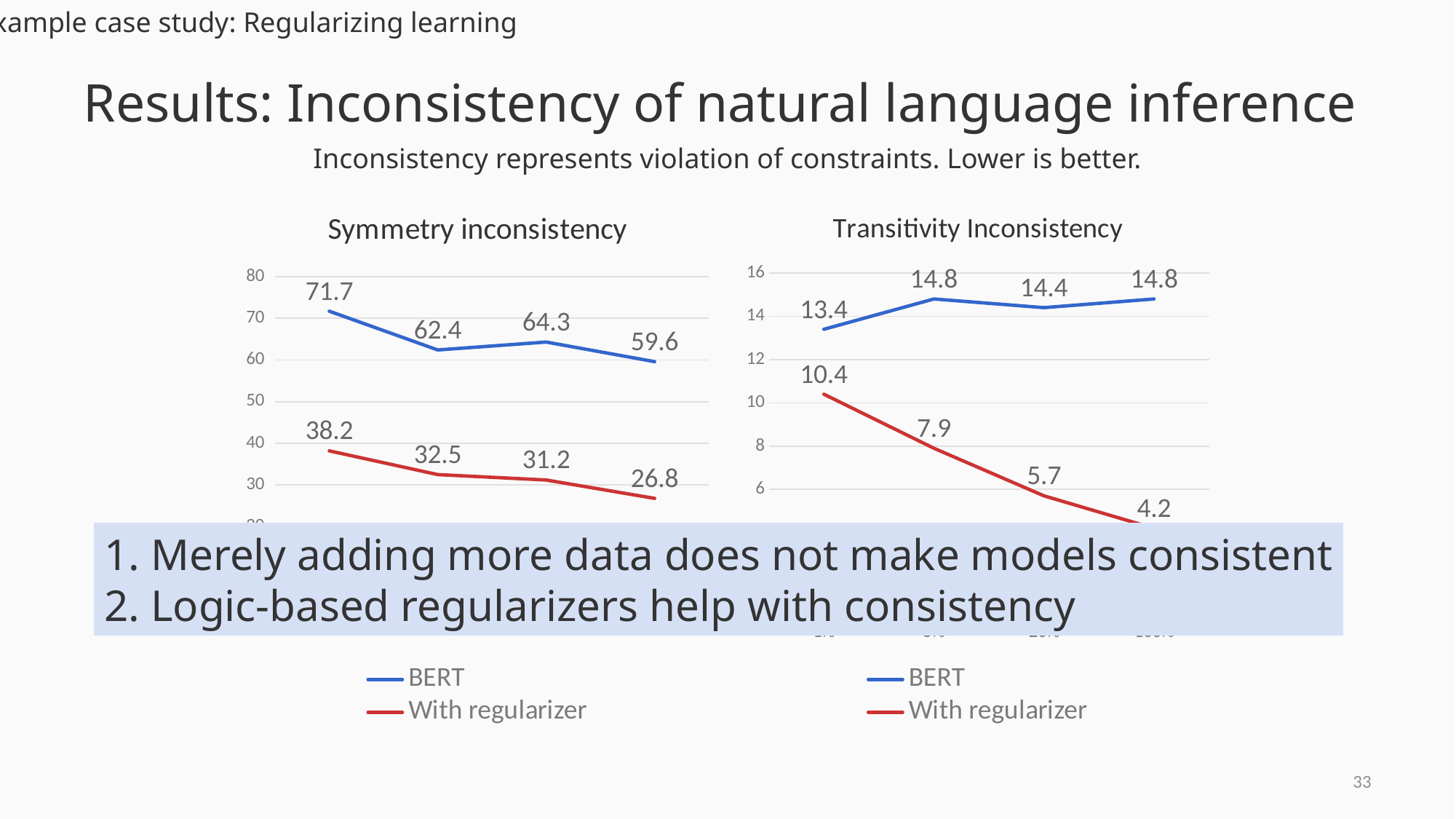
In the Transitivity Inconsistency chart, what is the lowest value of the With regularizer series? 4.2 In the Transitivity Inconsistency chart, what is the first value of the With regularizer series? 10.4 In the Symmetry inconsistency chart, what is the highest value of the BERT series? 71.7 How many data points does the BERT series have in the Transitivity Inconsistency chart? 4 In the Transitivity Inconsistency chart, what is the difference between the first and last values of the With regularizer series? 6.2 In the Symmetry inconsistency chart, what is the first value of the BERT series? 71.7 In the Transitivity Inconsistency chart, what is the third value of the BERT series? 14.4 What type of chart is the Symmetry inconsistency chart? line chart In the Symmetry inconsistency chart, what is the last value of the With regularizer series? 26.8 In the Symmetry inconsistency chart, what is the difference between the first BERT value and the first With regularizer value? 33.5 In the Transitivity Inconsistency chart, does the With regularizer series rise or fall along the x axis? fall How many series does the legend of the Symmetry inconsistency chart list? 2